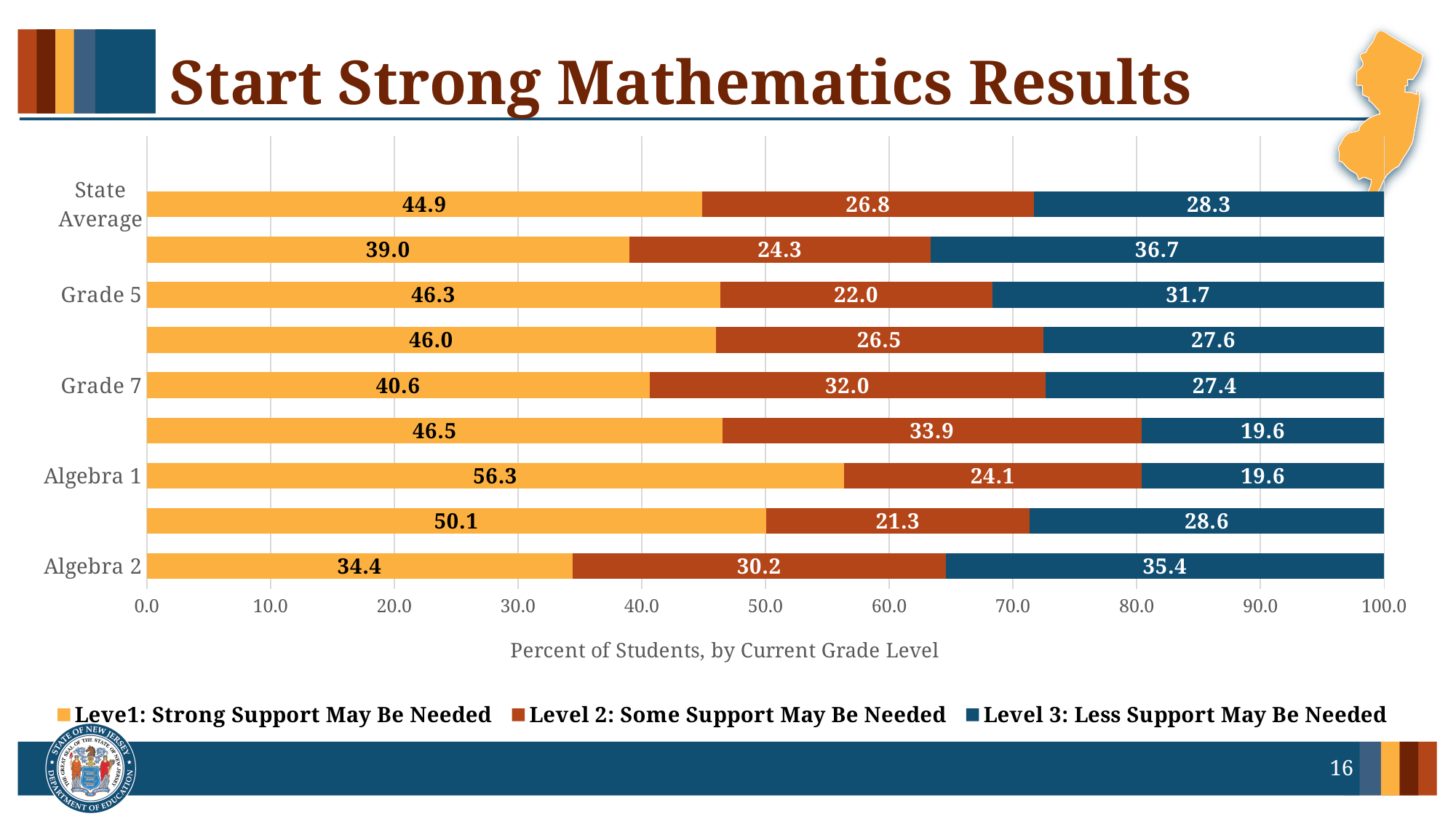
What kind of chart is shown on the slide? Stacked bar chart Which labeled category has the highest Level 1 (Strong Support May Be Needed) value? Algebra 1 What is the Level 2 (Some Support May Be Needed) value for Grade 7? 32.0 Which has a larger Level 2 (Some Support May Be Needed) value, Grade 5 or Grade 7? Grade 7 Which labeled category has the lowest Level 1 (Strong Support May Be Needed) value? Algebra 2 What is the Level 1 (Strong Support May Be Needed) value for Algebra 1? 56.3 What is the x-axis title of the chart? Percent of Students, by Current Grade Level What is the Level 3 (Less Support May Be Needed) value for the State Average? 28.3 What is the difference between the Level 1 values for Algebra 1 and Algebra 2? 21.9 What is the total of the stacked bar for the State Average? 100.0 Is the Level 1 value for Algebra 2 greater or less than 40.0? less How many series does the legend list? 3